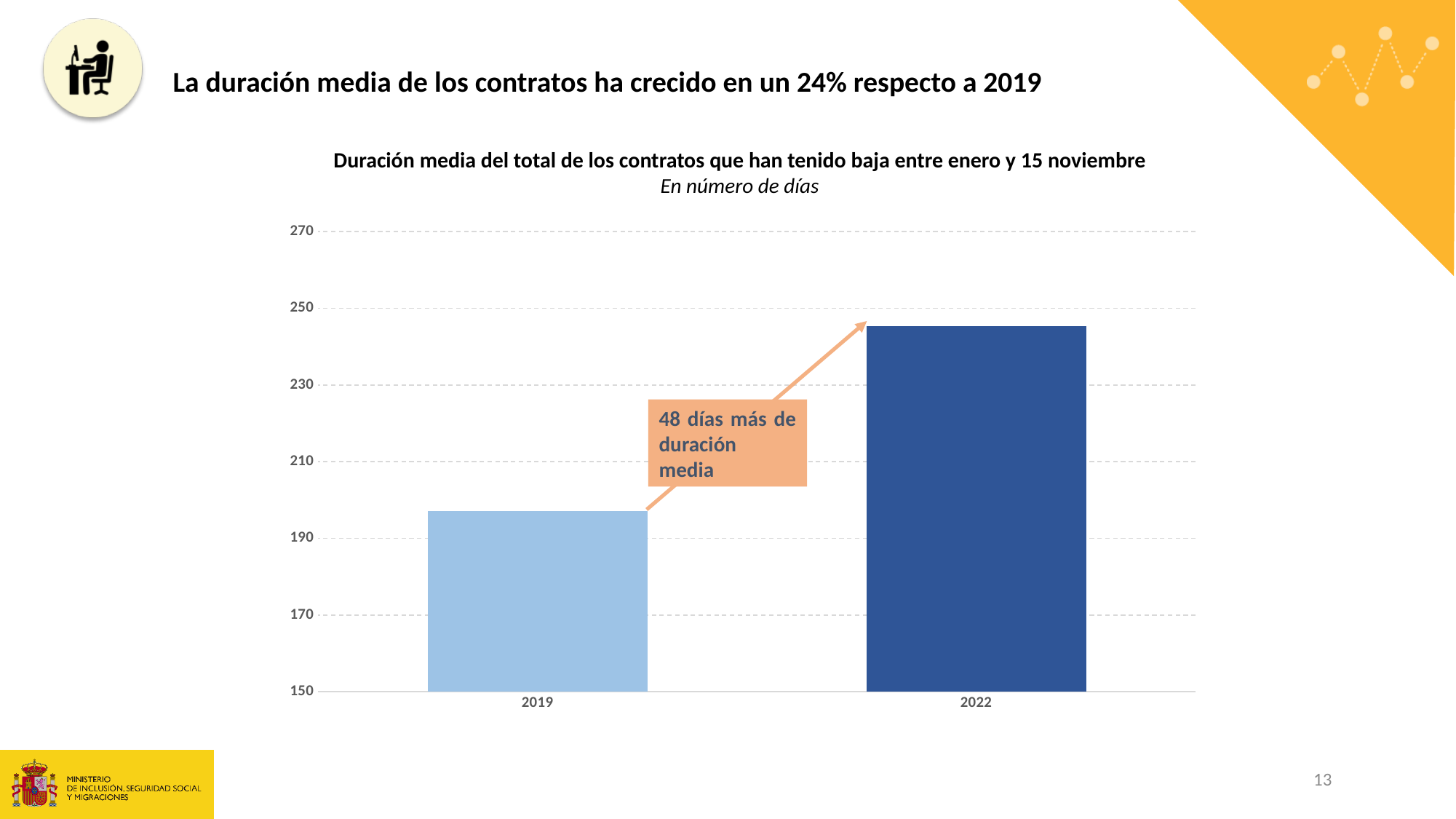
In what unit are the values of the chart expressed, according to the subtitle? En número de días Is the value for 2022 greater or less than 230? greater Is the bar for 2022 larger or smaller than the bar for 2019? larger What kind of chart is shown on the slide? bar chart Do the values rise or fall from 2019 to 2022? rise Which year has the higher average contract duration? 2022 Is the value for 2022 greater or less than 250? less Is the value for 2019 greater or less than 210? less How many bars (categories) does the chart show? 2 Which year has the lower average contract duration? 2019 According to the annotation on the chart, by how many days did the average duration increase between 2019 and 2022? 48 días